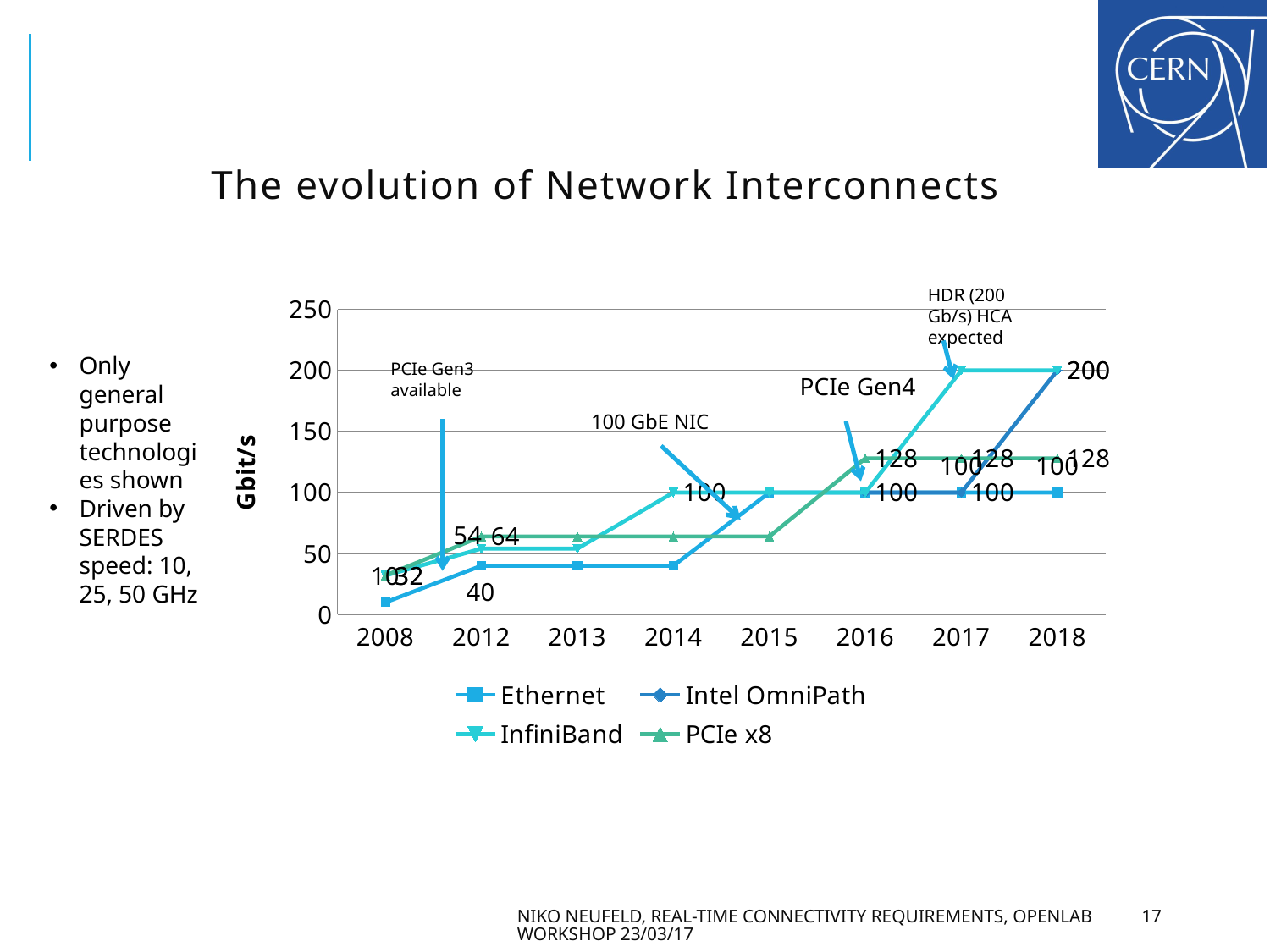
What is the InfiniBand value in 2018? 200 What is the label on the y axis of the chart? Gbit/s What is the PCIe x8 value in 2016? 128 How many series does the chart legend list? 4 Is the Ethernet value in 2014 greater or less than 50? less What is the difference between the PCIe x8 value and the InfiniBand value in 2012? 10 What kind of chart is shown on the slide? line chart What is the PCIe x8 value in 2012? 64 What is the Ethernet value in 2012? 40 Which series has the lowest value in 2012? Ethernet What is the difference between the InfiniBand value and the Ethernet value in 2018? 100 How many years are shown on the x axis of the chart? 8